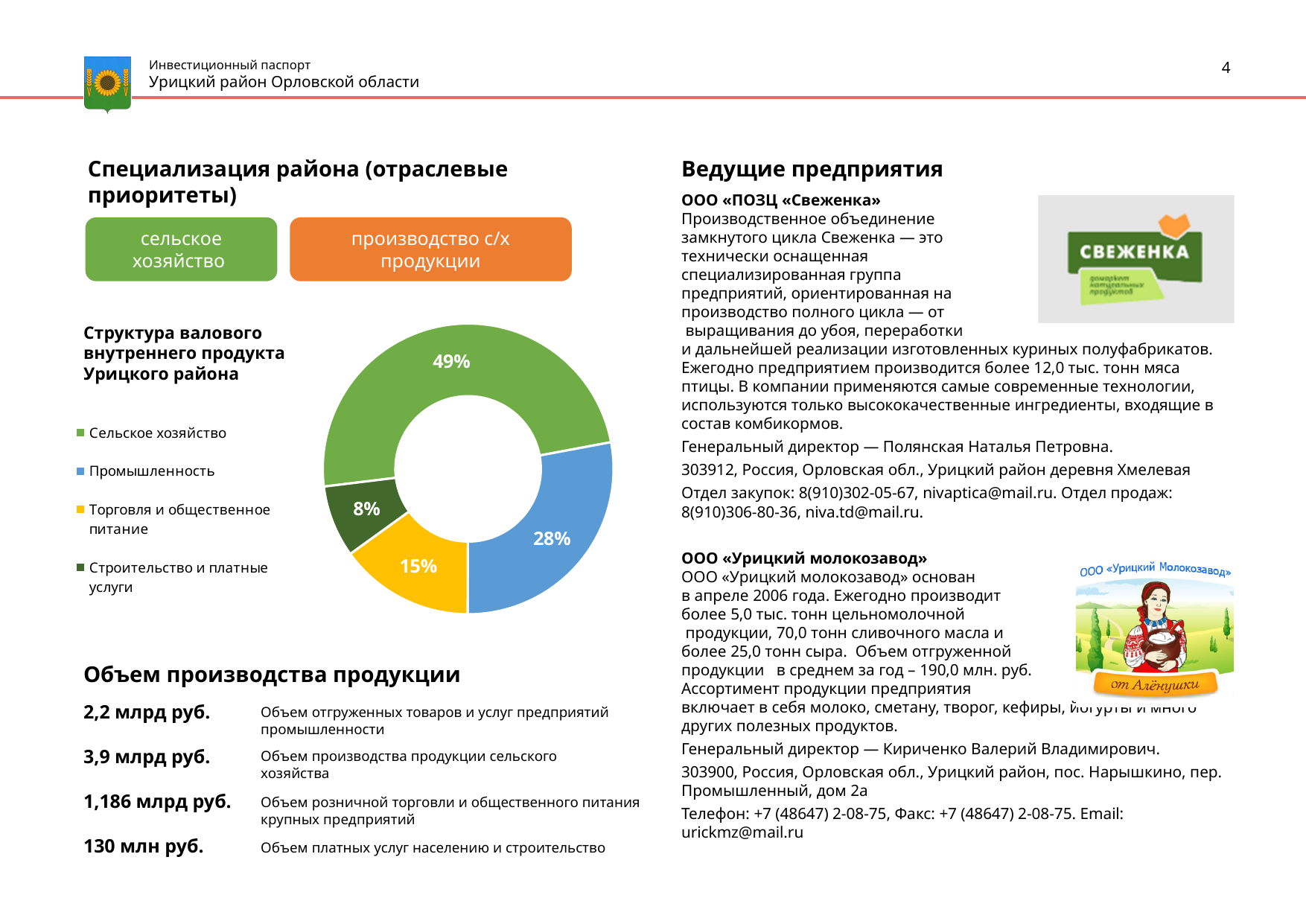
How many categories are shown in the donut chart? 4 Which category has the largest share of the gross domestic product? Сельское хозяйство What type of chart is used to show the structure of the gross domestic product of Урицкий район? Donut (pie) chart What is the combined share of Торговля и общественное питание and Строительство и платные услуги? 23% What is the difference in percentage points between Сельское хозяйство and Промышленность? 21 percentage points Which category has the smallest share of the gross domestic product? Строительство и платные услуги What share of the gross domestic product does Промышленность account for? 28% What share of the gross domestic product does Сельское хозяйство account for? 49% What colour represents Промышленность in the donut chart? Blue What share of the gross domestic product does Торговля и общественное питание account for? 15% What share of the gross domestic product does Строительство и платные услуги account for? 8% Which is larger: the share of Промышленность or the share of Торговля и общественное питание? Промышленность